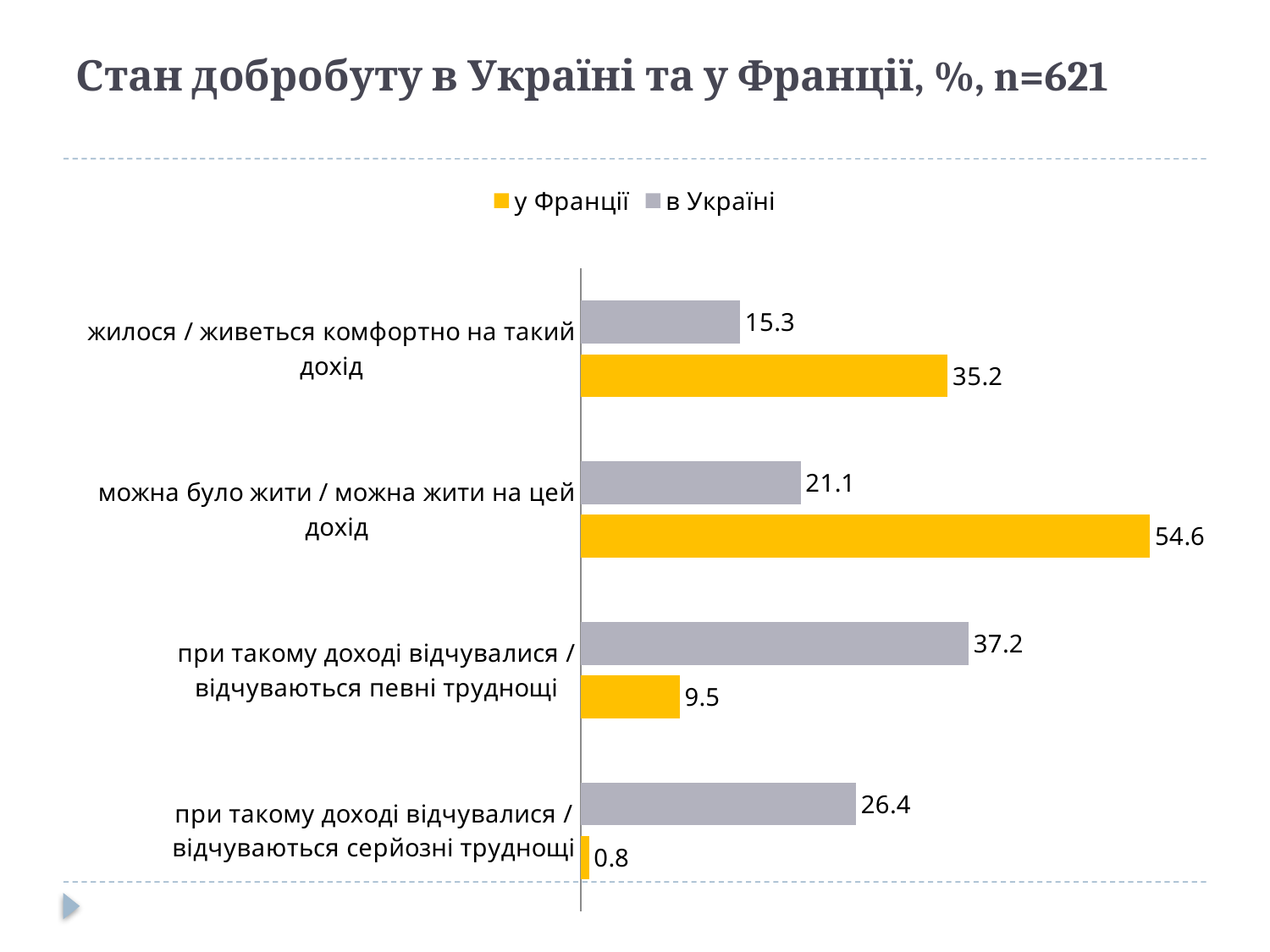
What is the value for "у Франції" in the category "можна було жити / можна жити на цей дохід"? 54.6 What is the value for "у Франції" in the category "при такому доході відчувалися / відчуваються серйозні труднощі"? 0.8 Which category has the lowest value for "в Україні"? жилося / живеться комфортно на такий дохід What is the difference between the "у Франції" and "в Україні" values for "можна було жити / можна жити на цей дохід"? 33.5 What is the value for "в Україні" in the category "жилося / живеться комфортно на такий дохід"? 15.3 Which category has the highest value for "у Франції"? можна було жити / можна жити на цей дохід How many categories are shown in the chart? 4 How many series does the legend list? 2 Which colour represents the series "у Франції"? yellow What kind of chart is shown on the slide? bar chart What is the value for "в Україні" in the category "при такому доході відчувалися / відчуваються певні труднощі"? 37.2 For "при такому доході відчувалися / відчуваються серйозні труднощі", which series has the larger value, "у Франції" or "в Україні"? в Україні